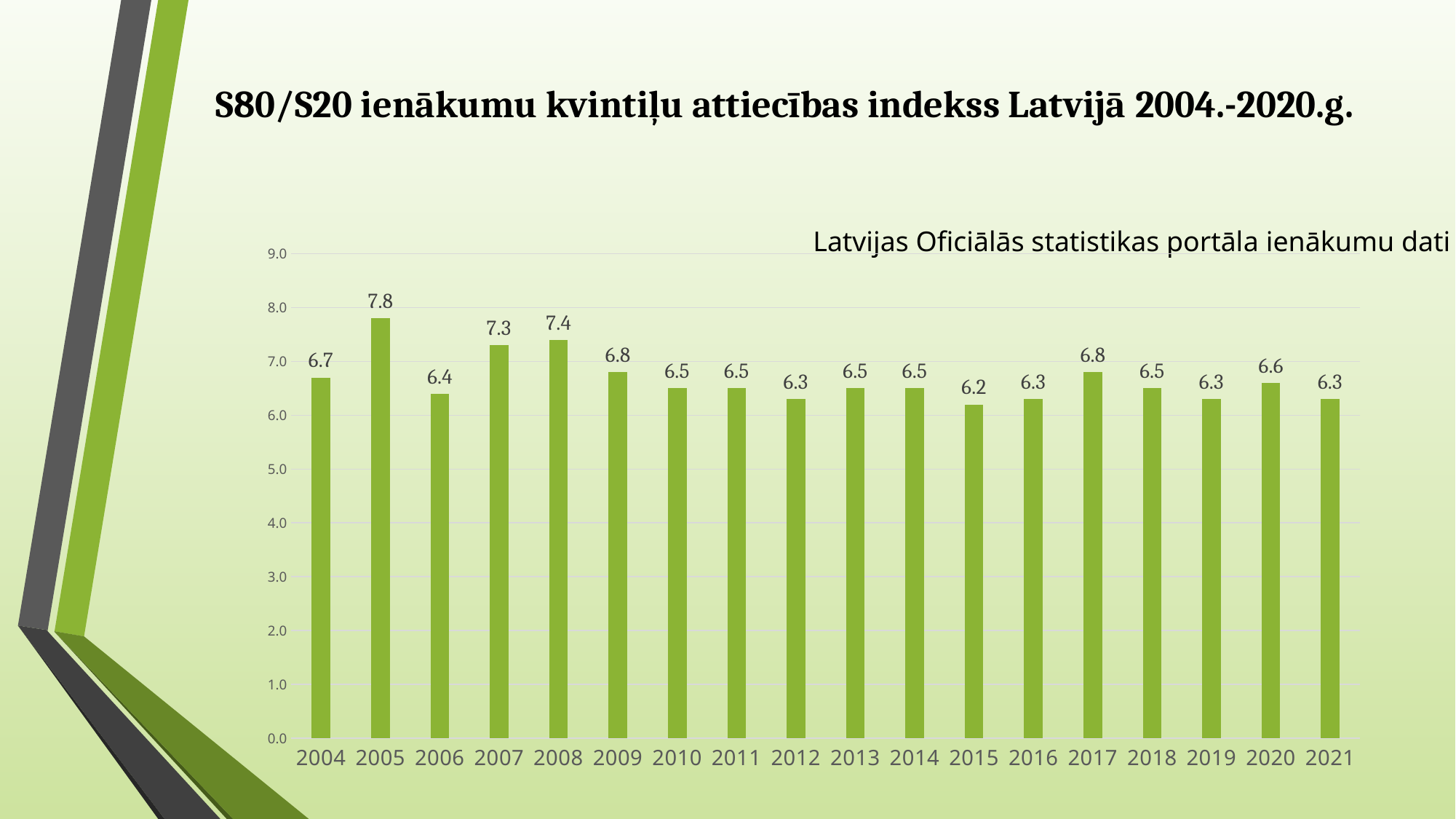
What is the value for 2005? 7.8 What kind of chart is this? bar chart What is the difference between the values for 2005 and 2006? 1.4 What is the value for 2015? 6.2 How many years are shown on the x axis? 18 What is the title of the chart? S80/S20 ienākumu kvintiļu attiecības indekss Latvijā 2004.-2020.g. Which year has the highest value? 2005 Which is larger, the value for 2007 or the value for 2009? 2007 What is the value for 2020? 6.6 Is the value for 2005 greater or less than 7.0? greater What is the difference between the values for 2008 and 2021? 1.1 Which year has the lowest value? 2015